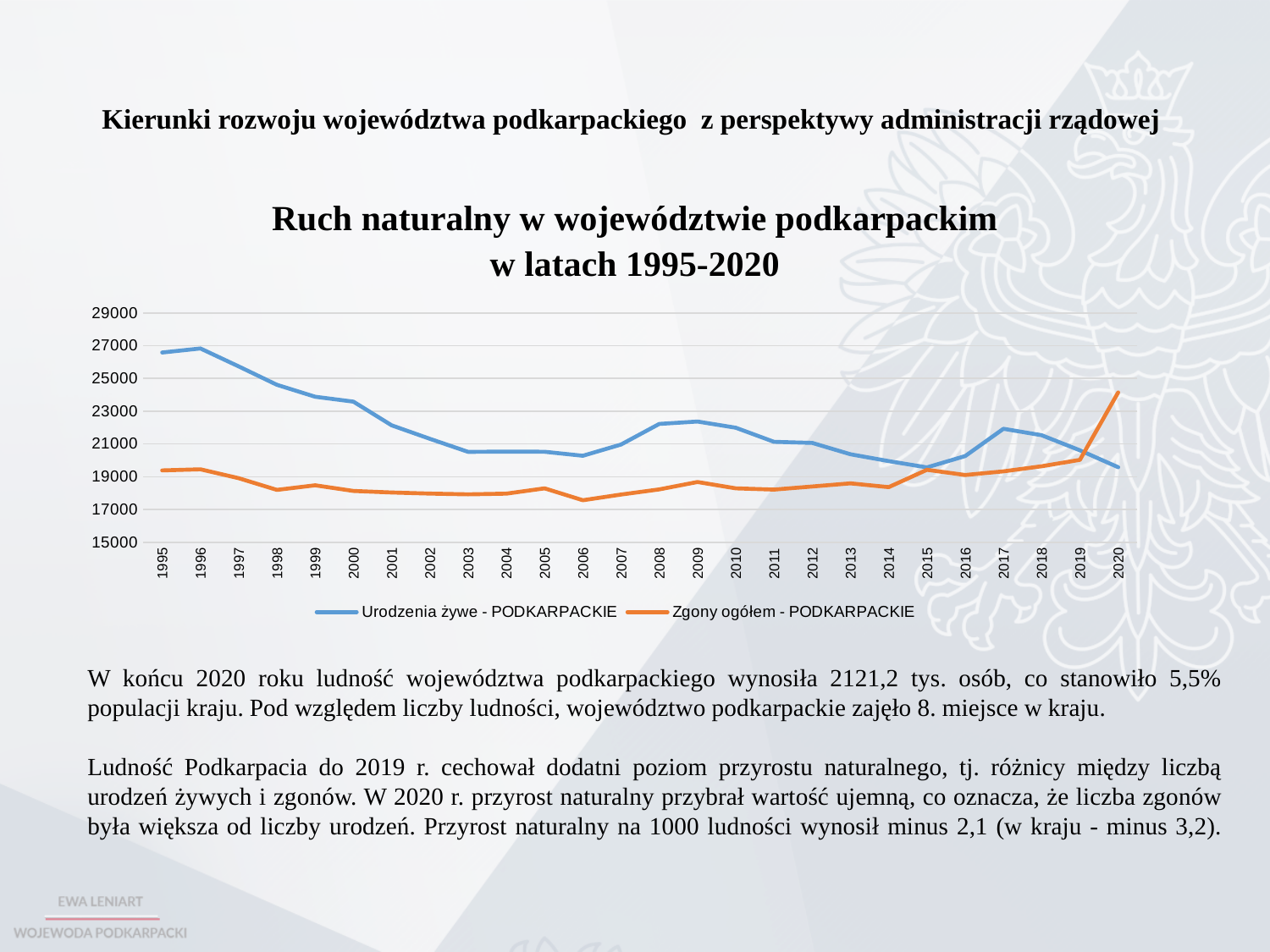
In 2020, which series has the larger value: 'Urodzenia żywe - PODKARPACKIE' or 'Zgony ogółem - PODKARPACKIE'? Zgony ogółem - PODKARPACKIE How many years are plotted along the x axis of the chart? 26 In which year does the 'Zgony ogółem - PODKARPACKIE' series reach its highest value? 2020 Is the value for 'Zgony ogółem - PODKARPACKIE' in 2006 greater or less than 18000? less Is the value for 'Zgony ogółem - PODKARPACKIE' in 2020 greater or less than 23000? greater Does the 'Urodzenia żywe - PODKARPACKIE' series generally rise or fall from 1995 to 2020? fall What kind of chart is shown on the slide? line chart How many series does the chart legend list? 2 Is the value for 'Urodzenia żywe - PODKARPACKIE' in 1995 greater or less than 25000? greater In which year does the 'Zgony ogółem - PODKARPACKIE' series reach its lowest value? 2006 What colour is the line for 'Urodzenia żywe - PODKARPACKIE' in the chart? blue